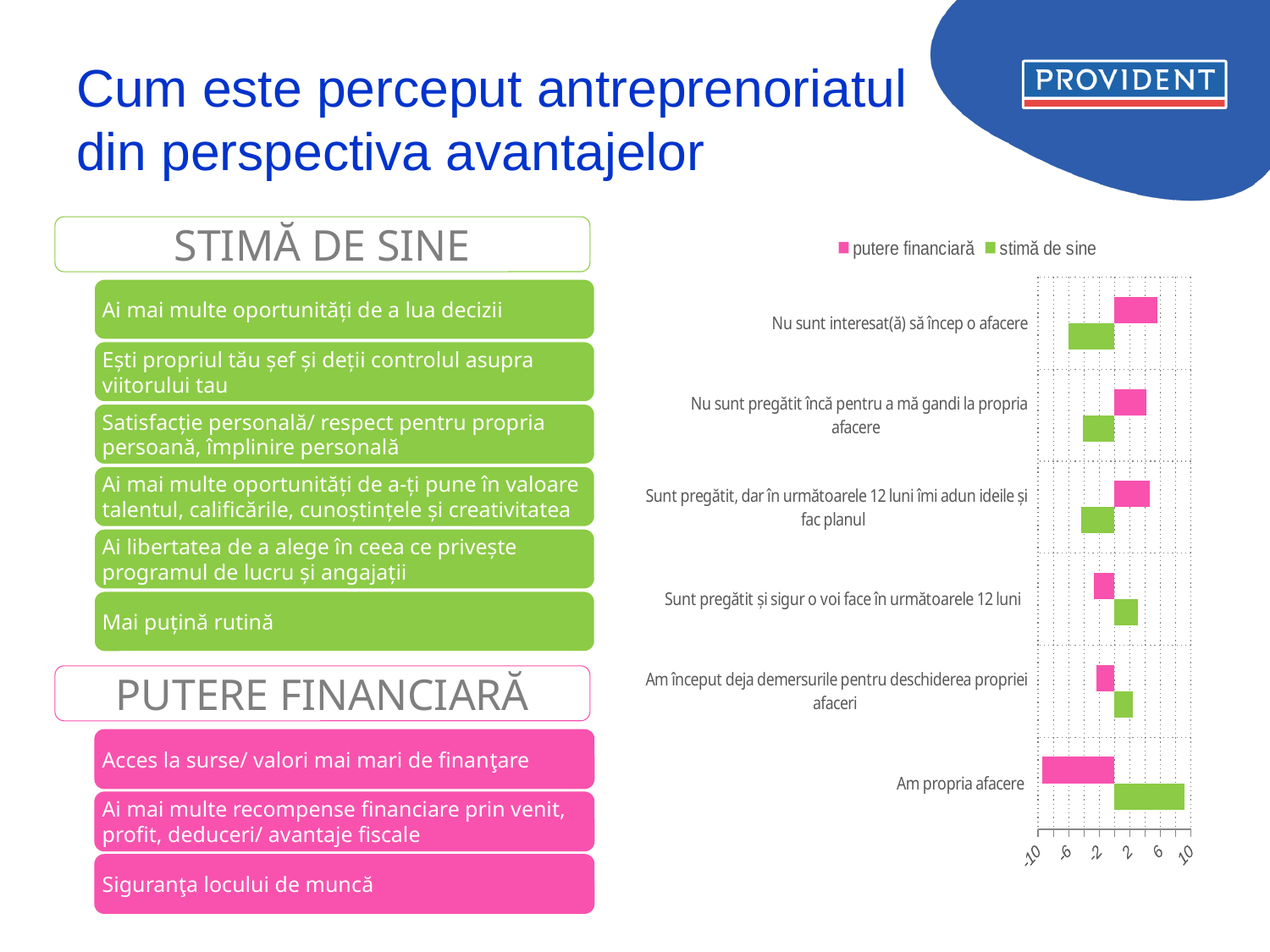
What kind of chart is shown on the right side of the slide? bar chart Which category has the highest value for the 'stimă de sine' series? Am propria afacere Is the 'stimă de sine' value for 'Am propria afacere' greater or less than 6? greater Which has the larger 'stimă de sine' value: 'Am propria afacere' or 'Am început deja demersurile pentru deschiderea propriei afaceri'? Am propria afacere Is the 'stimă de sine' value for 'Nu sunt interesat(ă) să încep o afacere' greater or less than -2? less What are the two series names shown in the chart legend? putere financiară and stimă de sine How many categories are plotted on the chart? 6 How many series does the chart legend list? 2 Which colour represents the 'putere financiară' series in the chart? pink Is the 'putere financiară' value for 'Nu sunt interesat(ă) să încep o afacere' greater or less than 2? greater Which category has the lowest value for the 'putere financiară' series? Am propria afacere